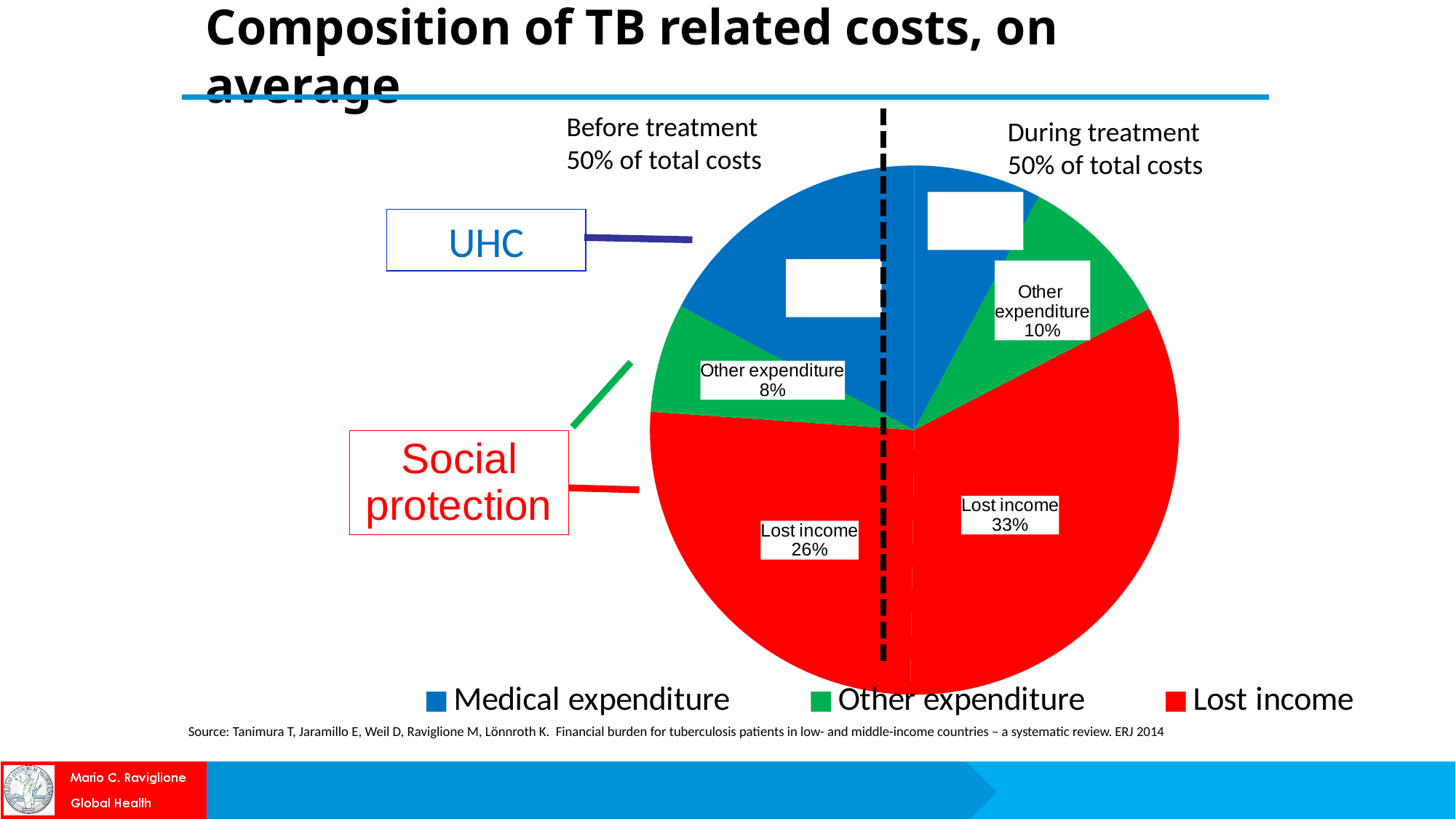
Which labelled slice has the largest share? Lost income during treatment (33%) Is lost income larger before treatment or during treatment? during treatment What is the share of other expenditure before treatment? 8% What kind of chart is shown on the slide? pie chart Which labelled slice has the smallest share? Other expenditure before treatment (8%) Which colour represents lost income in the legend? red What share of total costs is incurred before treatment? 50% What is the share of lost income during treatment? 33% What is the difference in percentage points between lost income during treatment and lost income before treatment? 7 What is the share of other expenditure during treatment? 10% How many categories does the legend list? 3 What is the share of lost income before treatment? 26%